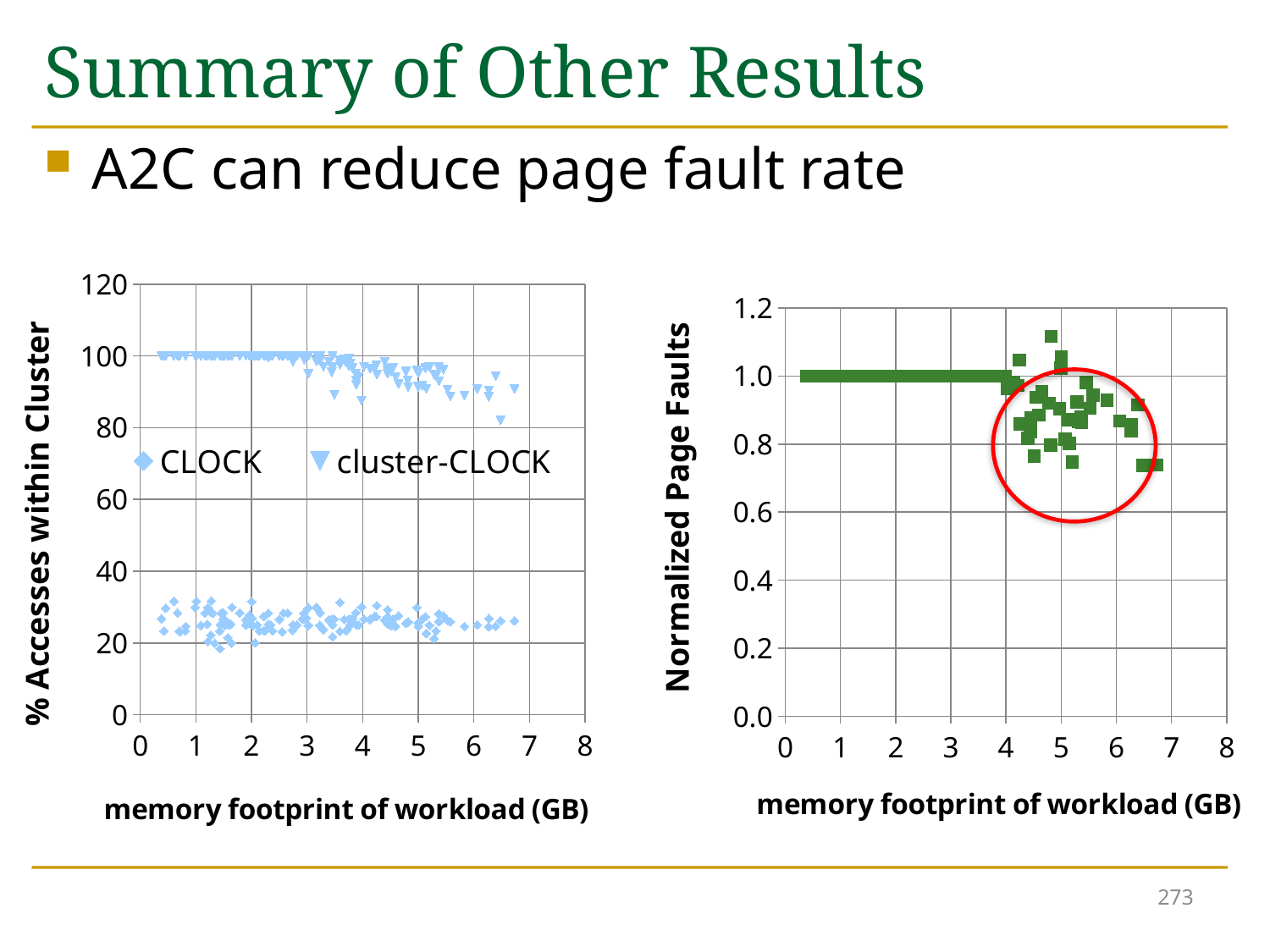
In the left chart, are the cluster-CLOCK values greater or less than 80? greater How many series does the legend of the left chart list? 2 In the right chart, what is the Normalized Page Faults value for workloads with a memory footprint below 4 GB? 1.0 What kind of chart is the right chart, with the y-axis 'Normalized Page Faults'? scatter chart In the left chart, which series has the higher % Accesses within Cluster, CLOCK or cluster-CLOCK? cluster-CLOCK In the right chart, do the Normalized Page Faults values generally rise or fall as the memory footprint increases beyond 4 GB? fall What kind of chart is the left chart, titled with the y-axis '% Accesses within Cluster'? scatter chart In the left chart, are the CLOCK values greater or less than 40? less What is the x-axis label of the left chart? memory footprint of workload (GB) What is the maximum value shown on the y-axis of the right chart? 1.2 What are the two series named in the legend of the left chart? CLOCK and cluster-CLOCK In the right chart, are the Normalized Page Faults values for workloads above 6 GB greater or less than 1.0? less